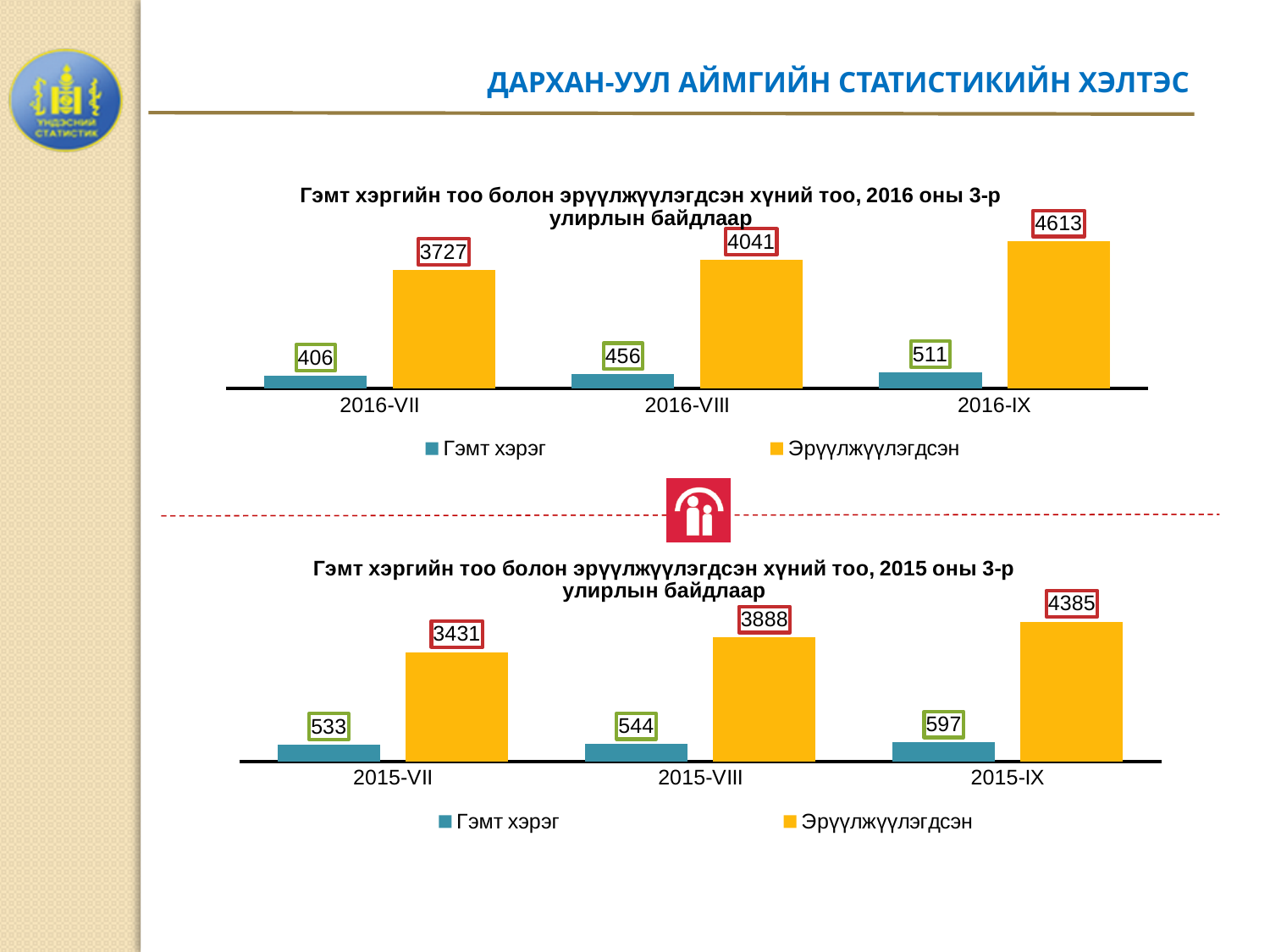
In the bottom chart (2015), what is the value of Эрүүлжүүлэгдсэн for 2015-VIII? 3888 In the bottom chart (2015), what is the difference between the Гэмт хэрэг values for 2015-IX and 2015-VIII? 53 In the top chart (2016), which month has the highest Эрүүлжүүлэгдсэн value? 2016-IX In the bottom chart (2015), what is the value of Гэмт хэрэг for 2015-VII? 533 In the top chart (2016), is the Гэмт хэрэг value for 2016-IX larger or smaller than the Гэмт хэрэг value for 2016-VII? larger What kind of chart is the top chart (2016)? bar chart In the top chart (2016), what is the difference between the Эрүүлжүүлэгдсэн values for 2016-IX and 2016-VII? 886 In the top chart (2016), what is the value of Гэмт хэрэг for 2016-VIII? 456 In the bottom chart (2015), which month has the lowest Гэмт хэрэг value? 2015-VII In the bottom chart (2015), do the Эрүүлжүүлэгдсэн values rise or fall from 2015-VII to 2015-IX? rise In the top chart (2016), what is the value of Эрүүлжүүлэгдсэн for 2016-IX? 4613 How many series does the legend of the bottom chart (2015) list? 2